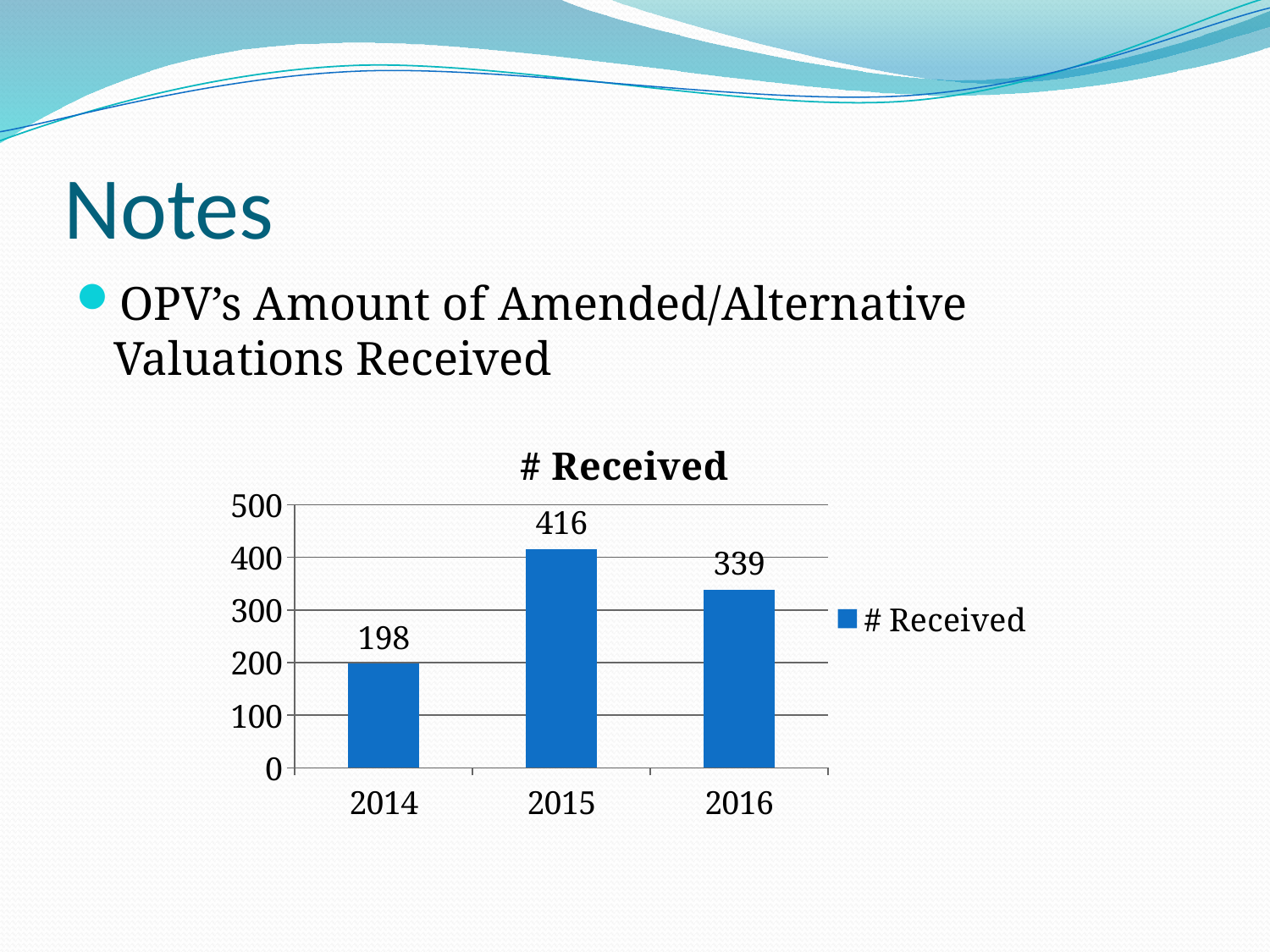
Is the value for 2016 greater or less than 300? greater Which year has the lowest number received? 2014 What is the value for 2014? 198 What is the title of the chart? # Received Which year has the highest number received? 2015 What is the difference between the values for 2015 and 2014? 218 Which is larger, the value for 2016 or the value for 2014? 2016 How many years are shown on the x axis? 3 What is the value for 2015? 416 What is the difference between the values for 2015 and 2016? 77 What kind of chart is shown? bar chart What is the value for 2016? 339